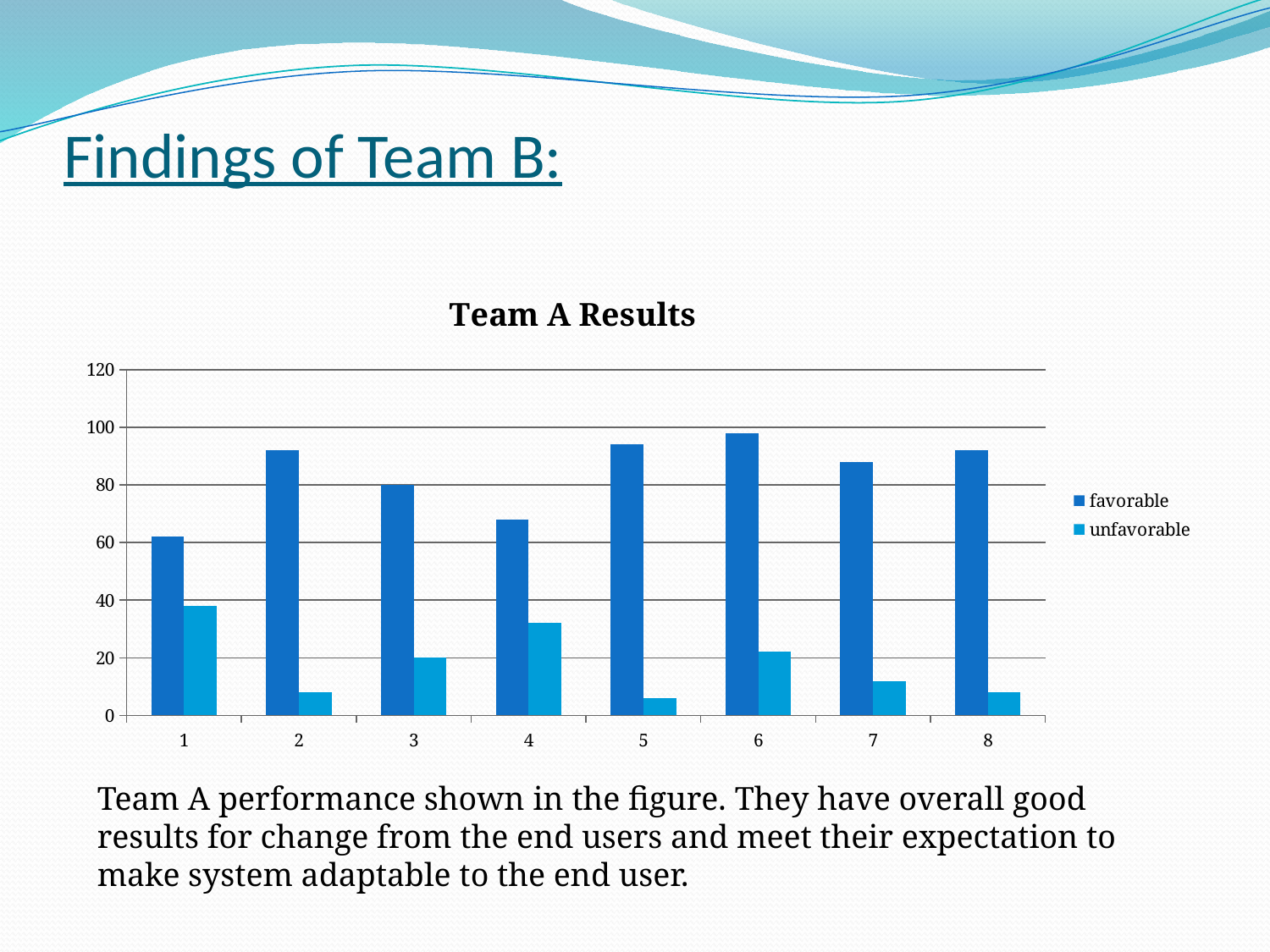
Which series is shown in the lighter blue colour? unfavorable How many categories are shown on the x axis? 8 Which is larger, the favorable value for category 2 or the favorable value for category 4? category 2 What is the title of the chart? Team A Results Is the favorable value for category 2 greater or less than 80? greater Which category has the highest unfavorable value? 1 Is the unfavorable value for category 4 greater or less than 20? greater Which category has the lowest favorable value? 1 Which category has the highest favorable value? 6 What kind of chart is shown on the slide? bar chart How many series does the legend list? 2 Is the unfavorable value for category 5 greater or less than 20? less